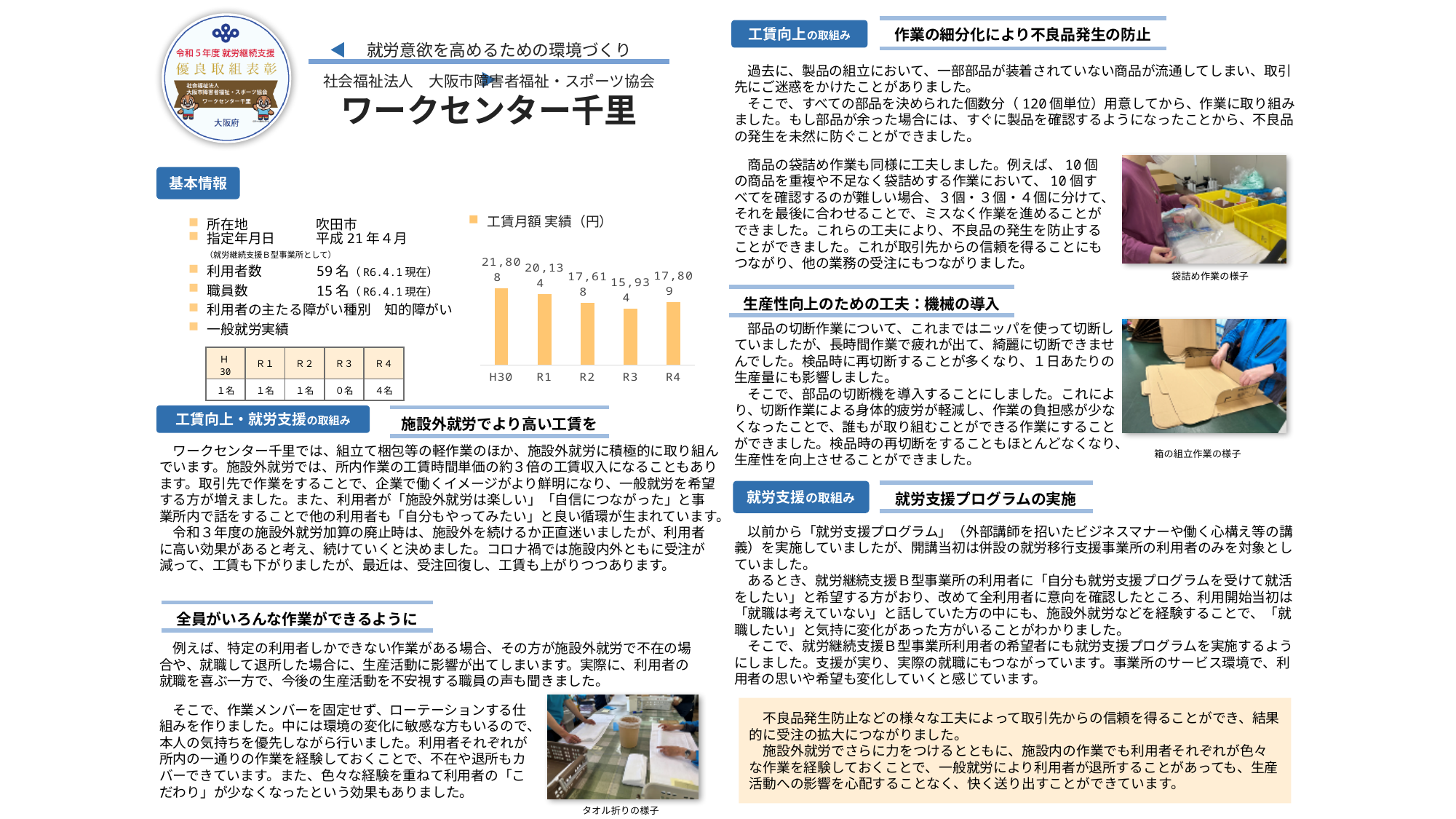
What is the title of the chart on the slide? 工賃月額 実績（円） How many categories are shown on the x axis of the 工賃月額 実績（円） chart? 5 What is the value for R3 in the 工賃月額 実績（円） chart? 15,934 In the 工賃月額 実績（円） chart, do the values rise or fall from H30 to R3? fall What kind of chart is the 工賃月額 実績（円） chart? bar chart Which category has the lowest value in the 工賃月額 実績（円） chart? R3 What is the value for R4 in the 工賃月額 実績（円） chart? 17,809 In the 工賃月額 実績（円） chart, what is the difference between the values for R4 and R3? 1,875 What is the value for H30 in the 工賃月額 実績（円） chart? 21,808 Which category has the highest value in the 工賃月額 実績（円） chart? H30 In the 工賃月額 実績（円） chart, which is larger, the value for R1 or the value for R2? R1 In the 工賃月額 実績（円） chart, what is the difference between the values for H30 and R1? 1,674